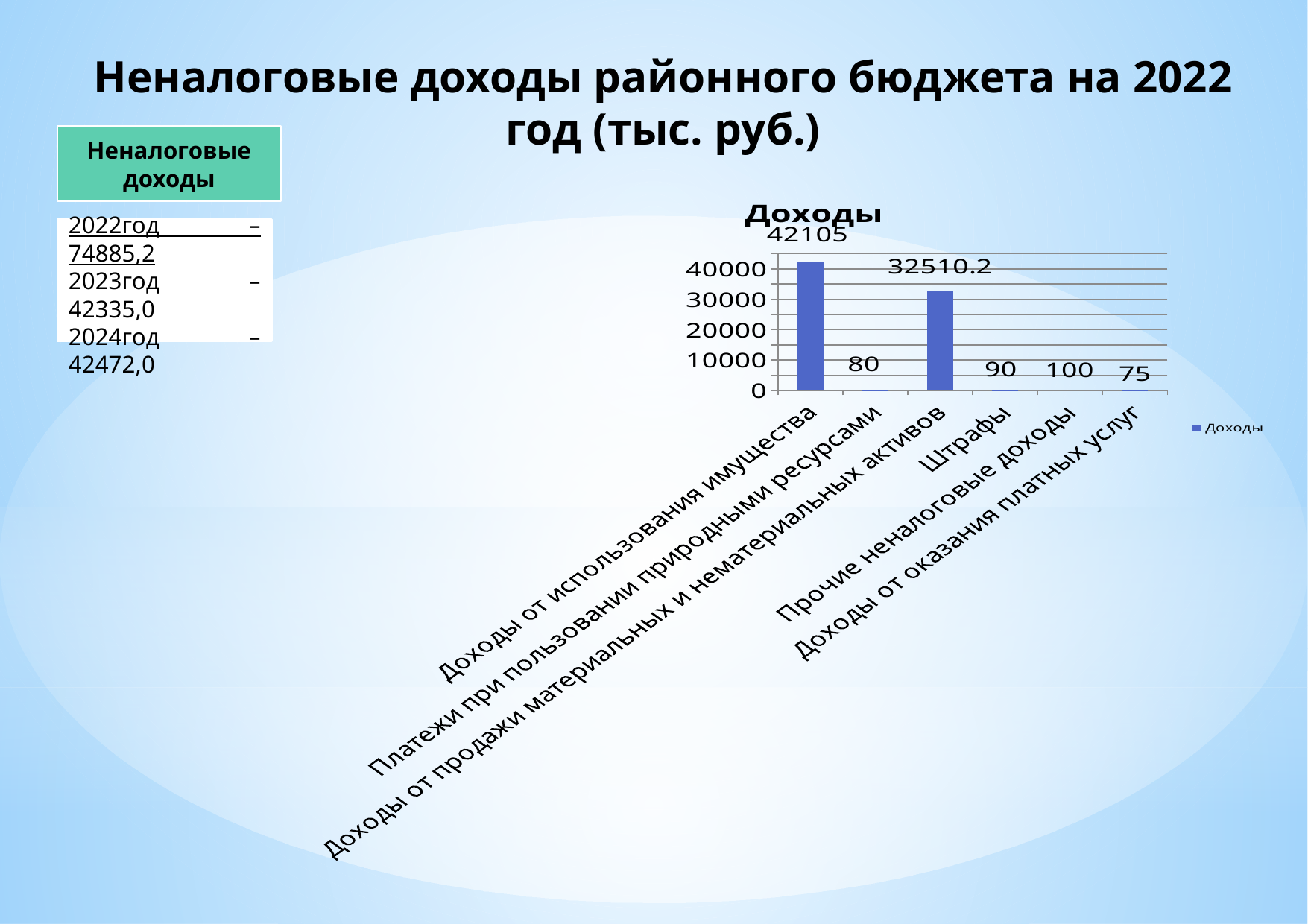
What is the value for Доходы от использования имущества? 42105 How many categories are shown on the x axis? 6 What type of chart is shown? Bar chart What is the value for Платежи при пользовании природными ресурсами? 80 Which category has the highest value? Доходы от использования имущества What is the value for Штрафы? 90 Which is larger, Прочие неналоговые доходы or Штрафы? Прочие неналоговые доходы What is the value for Доходы от оказания платных услуг? 75 How many series does the legend list? 1 Which category has the lowest value? Доходы от оказания платных услуг What is the value for Доходы от продажи материальных и нематериальных активов? 32510.2 What is the difference between Доходы от использования имущества and Доходы от продажи материальных и нематериальных активов? 9594.8